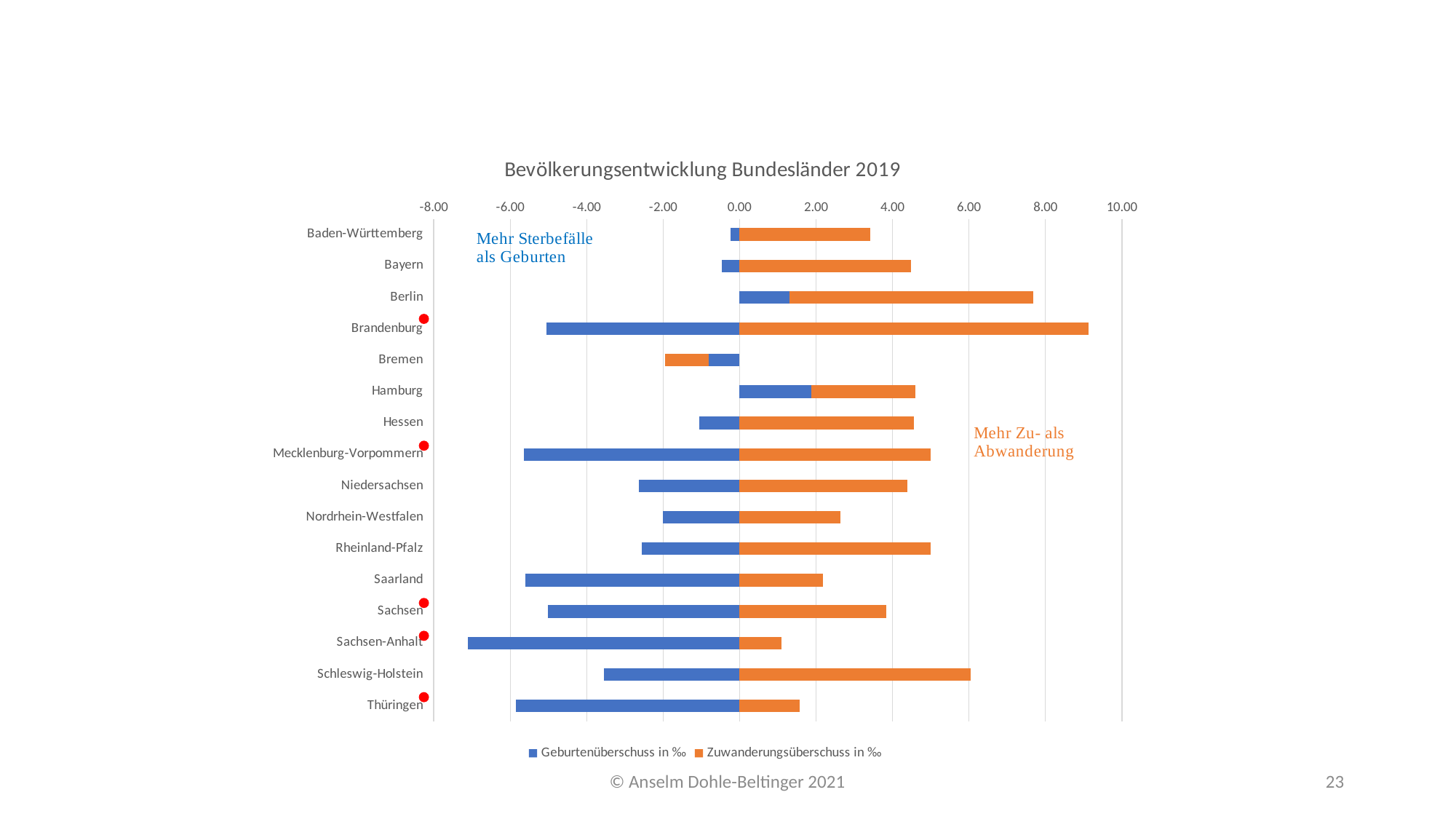
Is the Geburtenüberschuss for Sachsen-Anhalt greater or less than -6.00? less Which Bundesland has the highest Geburtenüberschuss? Hamburg How many series does the legend list? 2 Which Bundesland is the only one with a negative Zuwanderungsüberschuss? Bremen Which Bundesland has the highest Zuwanderungsüberschuss? Brandenburg What is the title of the chart? Bevölkerungsentwicklung Bundesländer 2019 How many Bundesländer (categories) are plotted in the chart? 16 What kind of chart is shown on the slide? bar chart Is the Zuwanderungsüberschuss for Brandenburg greater or less than 8.00? greater Which series is shown in orange according to the legend? Zuwanderungsüberschuss in ‰ Which Bundesland has the lowest (most negative) Geburtenüberschuss? Sachsen-Anhalt Which has the larger Zuwanderungsüberschuss, Saarland or Sachsen-Anhalt? Saarland